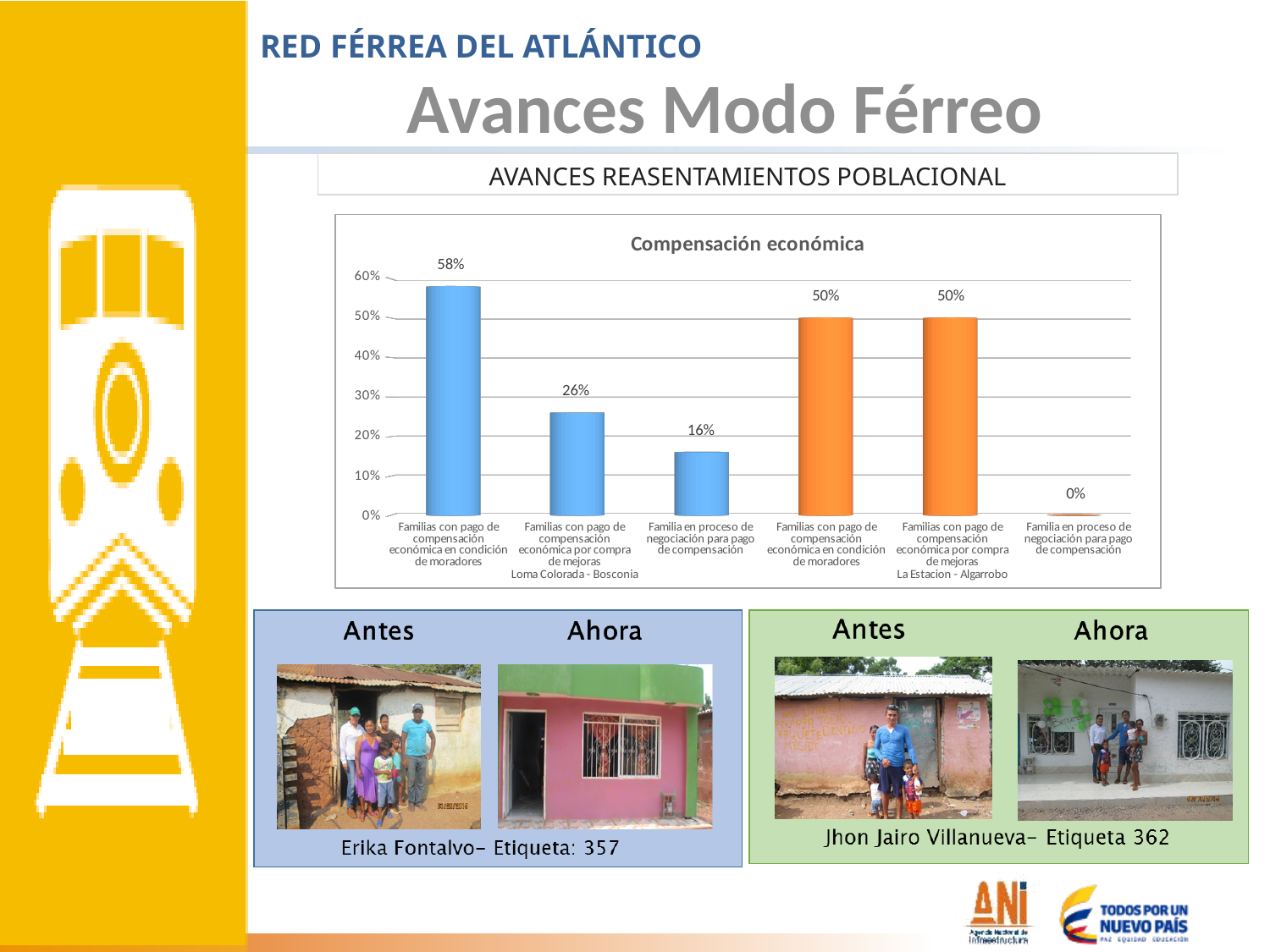
What type of chart is shown under "Compensación económica"? bar chart What colour are the bars for La Estacion - Algarrobo in the "Compensación económica" chart? orange What is the value for "Familia en proceso de negociación para pago de compensación" in Loma Colorada - Bosconia? 16% What is the value for "Familias con pago de compensación económica por compra de mejoras" in Loma Colorada - Bosconia? 26% Which category has the lowest value in the "Compensación económica" chart? Familia en proceso de negociación para pago de compensación (La Estacion - Algarrobo) Which category has the highest value in the "Compensación económica" chart? Familias con pago de compensación económica en condición de moradores (Loma Colorada - Bosconia) What is the value for "Familias con pago de compensación económica en condición de moradores" in Loma Colorada - Bosconia? 58% Which is larger: the value for "Familias con pago de compensación económica por compra de mejoras" in Loma Colorada - Bosconia or in La Estacion - Algarrobo? La Estacion - Algarrobo What is the value for "Familia en proceso de negociación para pago de compensación" in La Estacion - Algarrobo? 0% What is the difference between the value for families paid in condition of moradores in Loma Colorada - Bosconia (58%) and the same category in La Estacion - Algarrobo (50%)? 8% What is the title of the chart on the slide? Compensación económica How many bars are plotted in the "Compensación económica" chart? 6